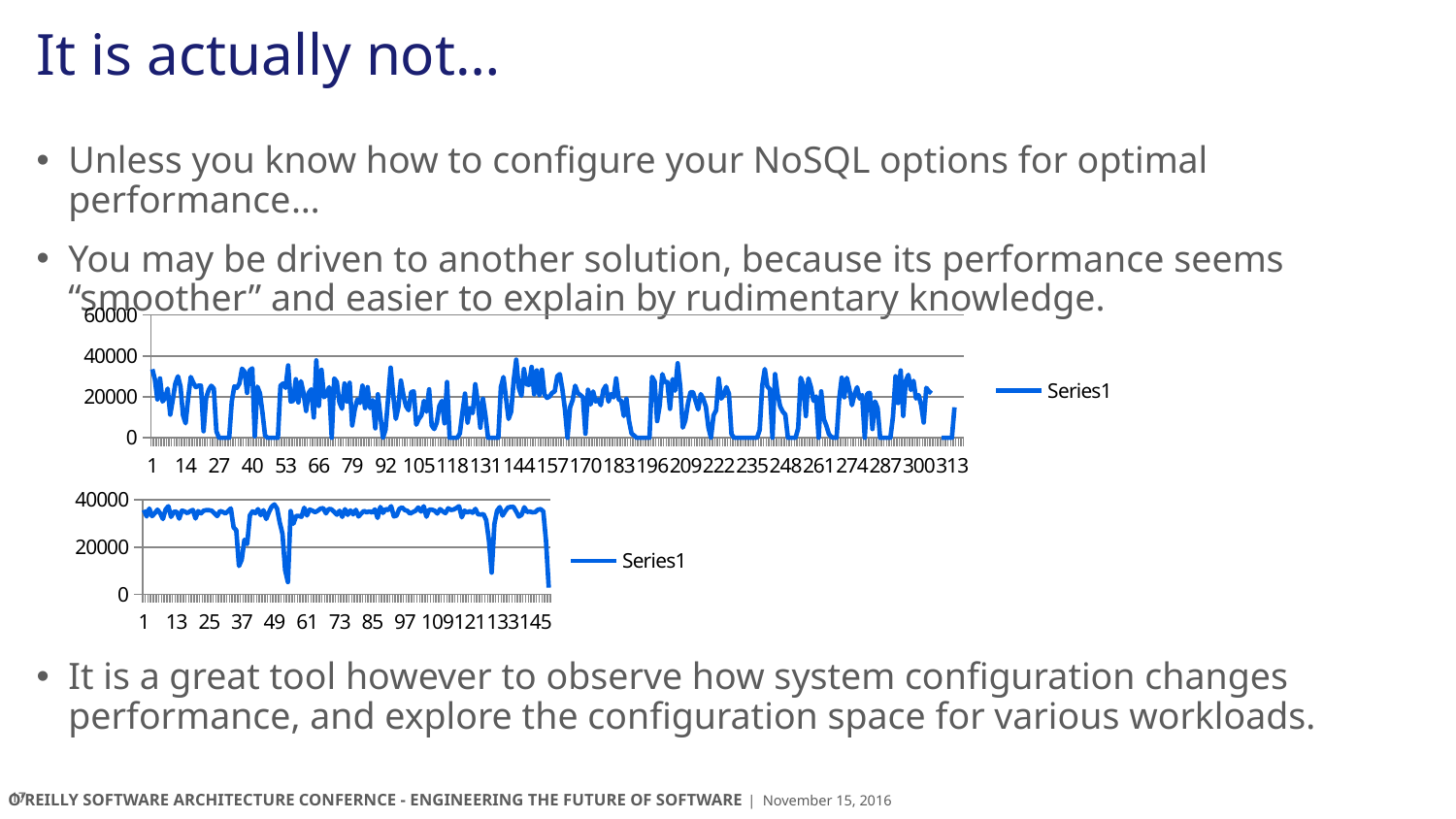
In the bottom chart, is the value at x = 13 greater or less than 20000? greater In the bottom chart, is the value at x = 1 greater or less than 20000? greater What is the highest value shown on the y axis of the top chart? 60000 What kind of chart is the bottom chart on the slide? line chart What is the name of the series shown in the legend of the top chart? Series1 What kind of chart is the top chart on the slide? line chart How many series does the legend of the bottom chart list? 1 How many series does the legend of the top chart list? 1 In the bottom chart, is the value at x = 85 greater or less than 20000? greater